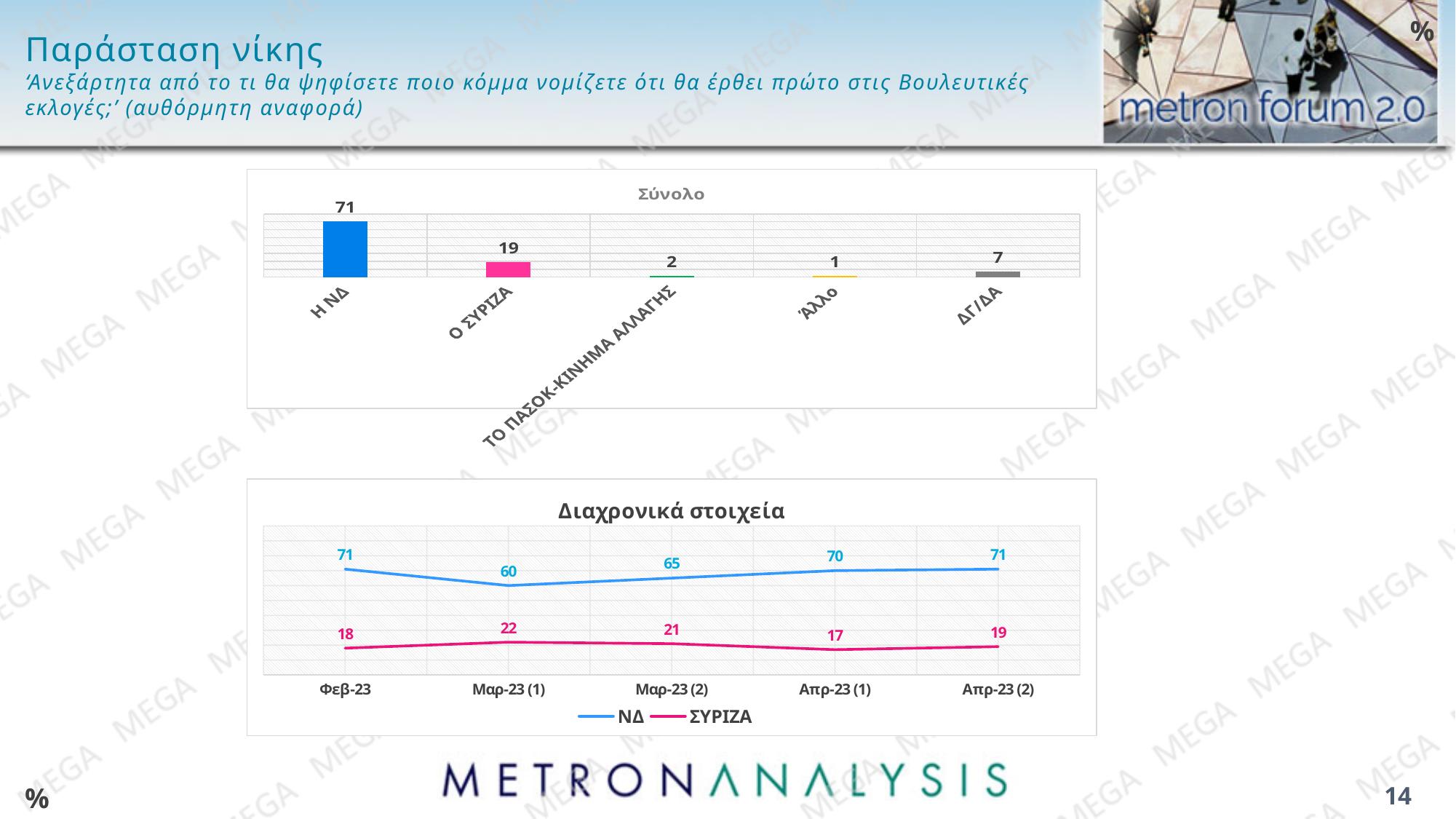
What kind of chart is the 'Σύνολο' chart? Bar chart In the 'Σύνολο' chart, what is the difference between the values for Η ΝΔ and Ο ΣΥΡΙΖΑ? 52 In the 'Διαχρονικά στοιχεία' chart, at which point does ΣΥΡΙΖΑ reach its highest value? Μαρ-23 (1) In the 'Σύνολο' chart, what is the value for ΔΓ/ΔΑ? 7 What kind of chart is the 'Διαχρονικά στοιχεία' chart? Line chart In the 'Σύνολο' chart, how many categories are shown? 5 In the 'Διαχρονικά στοιχεία' chart, what is the value for ΝΔ at Μαρ-23 (1)? 60 In the 'Διαχρονικά στοιχεία' chart, how many series does the legend list? 2 In the 'Διαχρονικά στοιχεία' chart, what is the value for ΣΥΡΙΖΑ at Απρ-23 (1)? 17 In the 'Σύνολο' chart, which category has the lowest value? Άλλο In the 'Διαχρονικά στοιχεία' chart, what is the difference between ΝΔ and ΣΥΡΙΖΑ at Φεβ-23? 53 In the 'Σύνολο' chart, what is the value for Η ΝΔ? 71